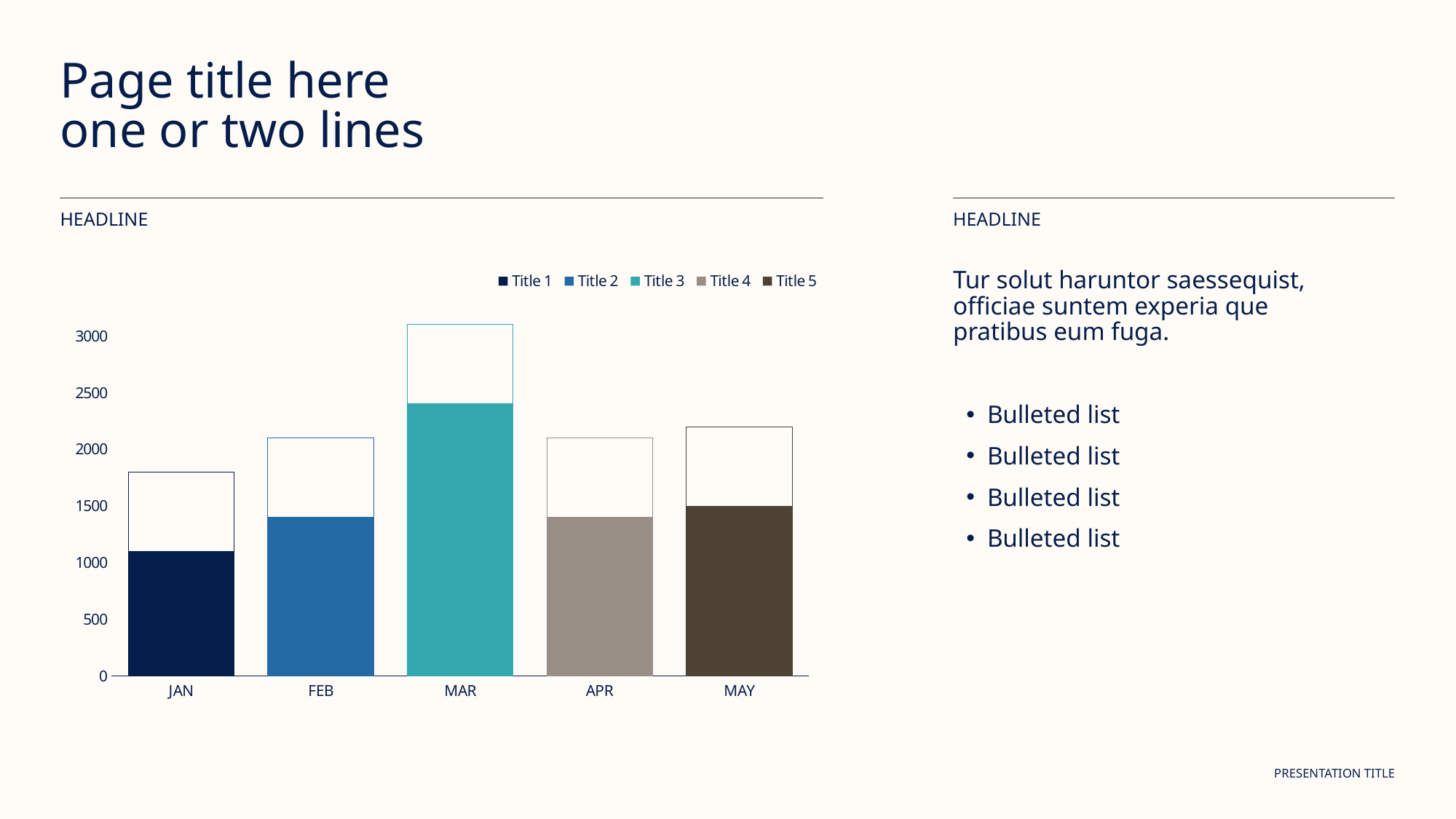
How many series does the chart's legend list? 5 How many categories are shown on the x axis of the chart? 5 Which filled bar is taller, JAN or MAY? MAY What is the name of the third series in the chart's legend? Title 3 Which month has the tallest filled bar in the chart? MAR Is the top of the outlined bar for MAR greater or less than 3000? greater Which month has the shortest filled bar in the chart? JAN Which filled bar is taller, MAR or FEB? MAR What kind of chart is shown on the slide? bar chart Is the filled bar value for JAN greater or less than 1500? less Is the filled bar value for MAR greater or less than 2000? greater